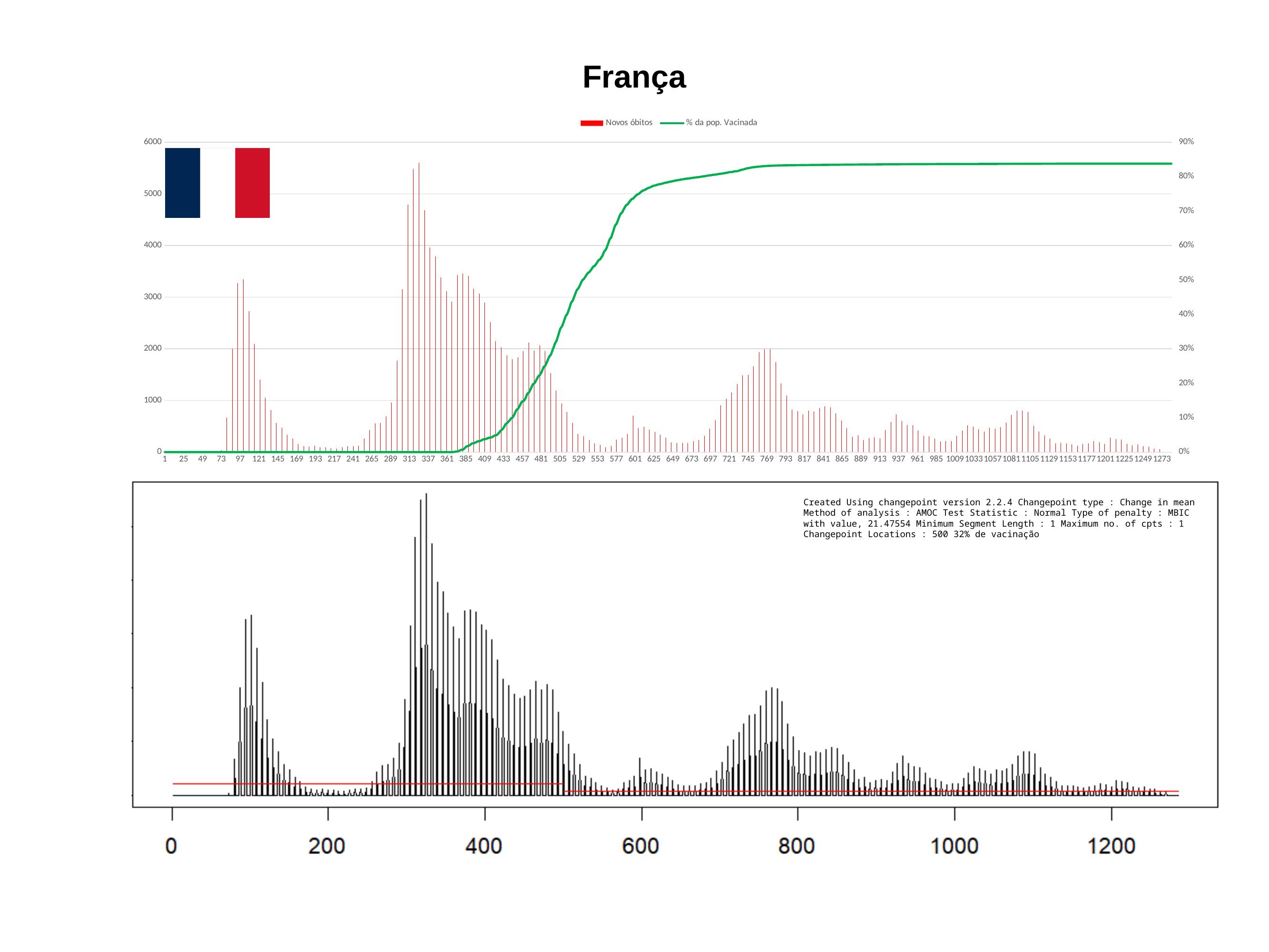
On the top chart, which is taller: the Novos óbitos peak around day 313–337 or the peak around day 769? The peak around day 313–337 On the bottom chart, at what location is the changepoint reported in the annotation text? 500 On the top chart, is the final value of the % da pop. Vacinada line greater or less than 80%? greater What kind of chart is the bottom chart? Bar chart On the top chart, does the % da pop. Vacinada line rise or fall along the x axis? Rises On the top chart, what are the two legend entries? Novos óbitos; % da pop. Vacinada On the top chart, how many series does the legend list? 2 On the top chart, what is the maximum value shown on the left vertical axis? 6000 On the top chart, is the tallest Novos óbitos bar (around day 313–337) greater or less than 5000? greater On the bottom chart, what vaccination percentage is given for the changepoint in the annotation text? 32% de vacinação On the top chart, what colour is the line for % da pop. Vacinada? Green On the top chart, is the peak of Novos óbitos around day 97 greater or less than 3000? greater